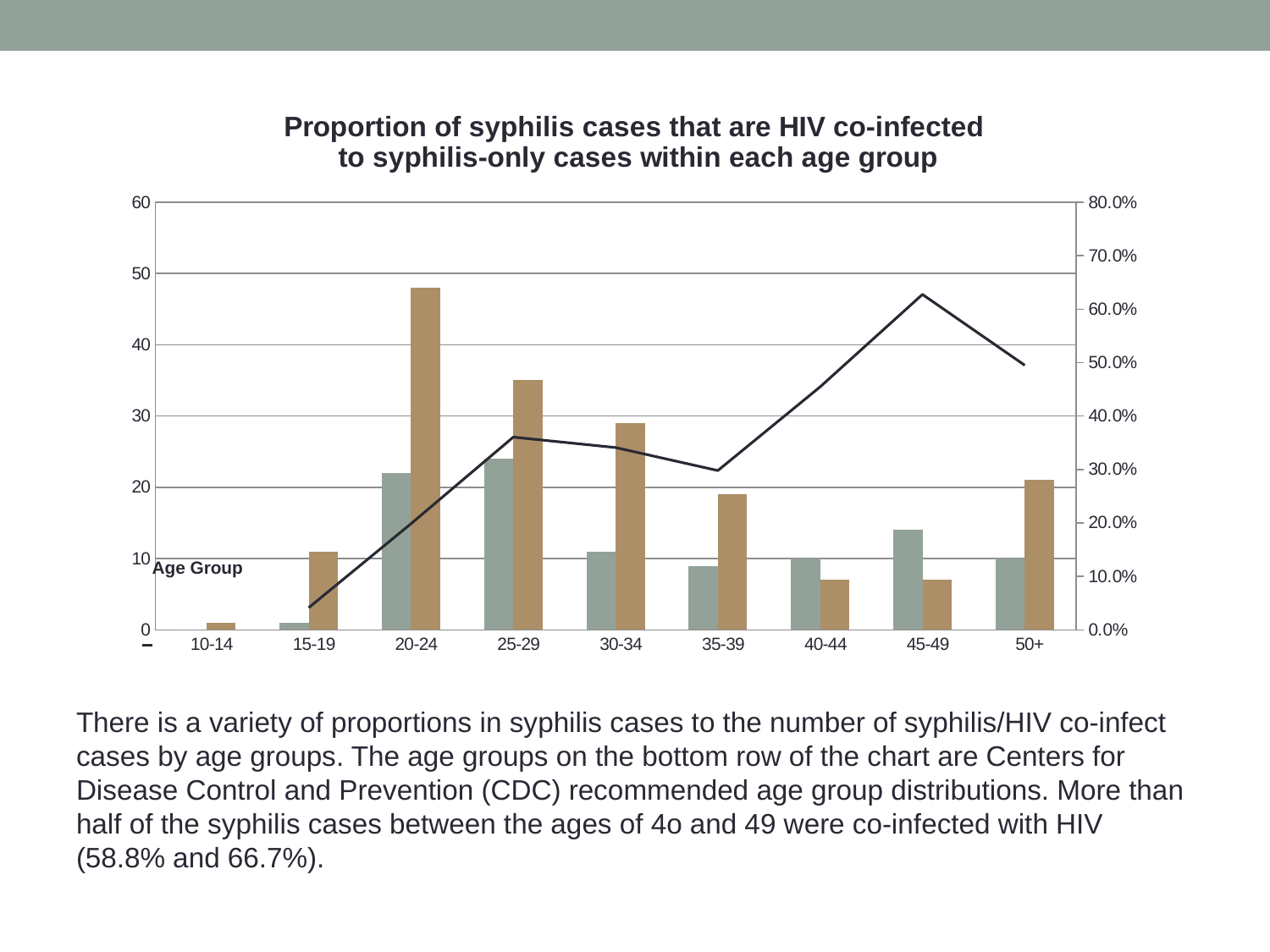
Does the line rise or fall from the 35-39 age group to the 45-49 age group? rises For the 20-24 age group, which bar is taller, the tan bar or the grey-green bar? tan bar What is the highest tick value shown on the right-hand axis? 80.0% Is the tan bar for the 20-24 age group greater or less than 40? greater For the 45-49 age group, which bar is taller, the tan bar or the grey-green bar? grey-green bar What kind of chart is shown on the slide? bar chart with a line overlay Which age group has the tallest tan bar? 20-24 What is the title of the chart? Proportion of syphilis cases that are HIV co-infected to syphilis-only cases within each age group Is the grey-green bar for the 30-34 age group greater or less than 20? less Is the line value for the 15-19 age group greater or less than 10.0%? less At which age group does the line reach its highest point? 45-49 How many age groups are shown along the x axis? 9